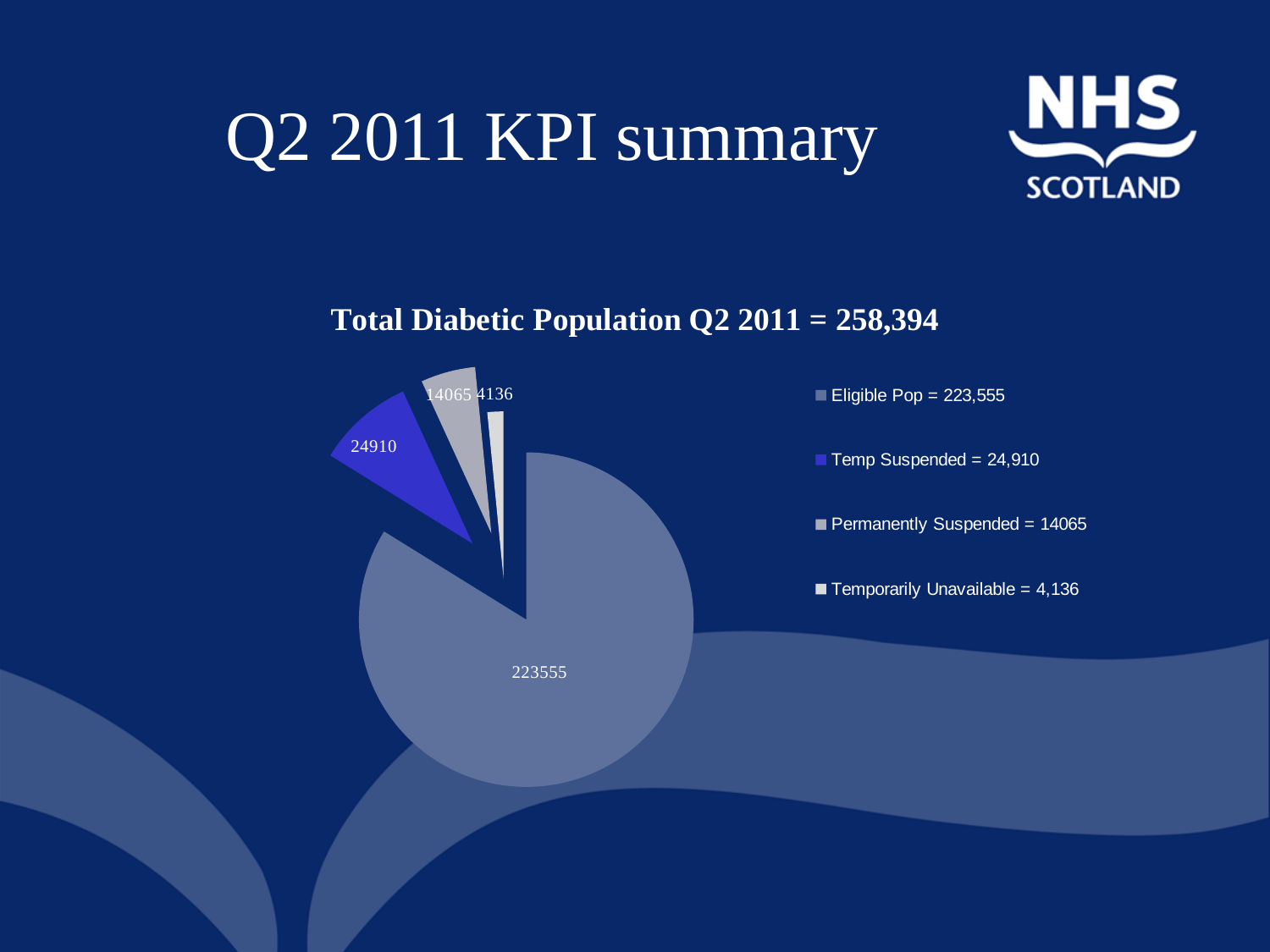
What is the difference between the Temp Suspended and Permanently Suspended values? 10845 Which category has the smallest slice of the pie? Temporarily Unavailable How many slices does the pie chart have? 4 Which category has the largest slice of the pie? Eligible Pop What type of chart is shown on the slide? Pie chart What is the value of the Temporarily Unavailable slice? 4136 What is the value of the Permanently Suspended slice? 14065 What is the value of the Eligible Pop slice? 223555 Which is larger, Permanently Suspended or Temporarily Unavailable? Permanently Suspended What is the value of the Temp Suspended slice? 24910 What is the title of the chart? Total Diabetic Population Q2 2011 = 258,394